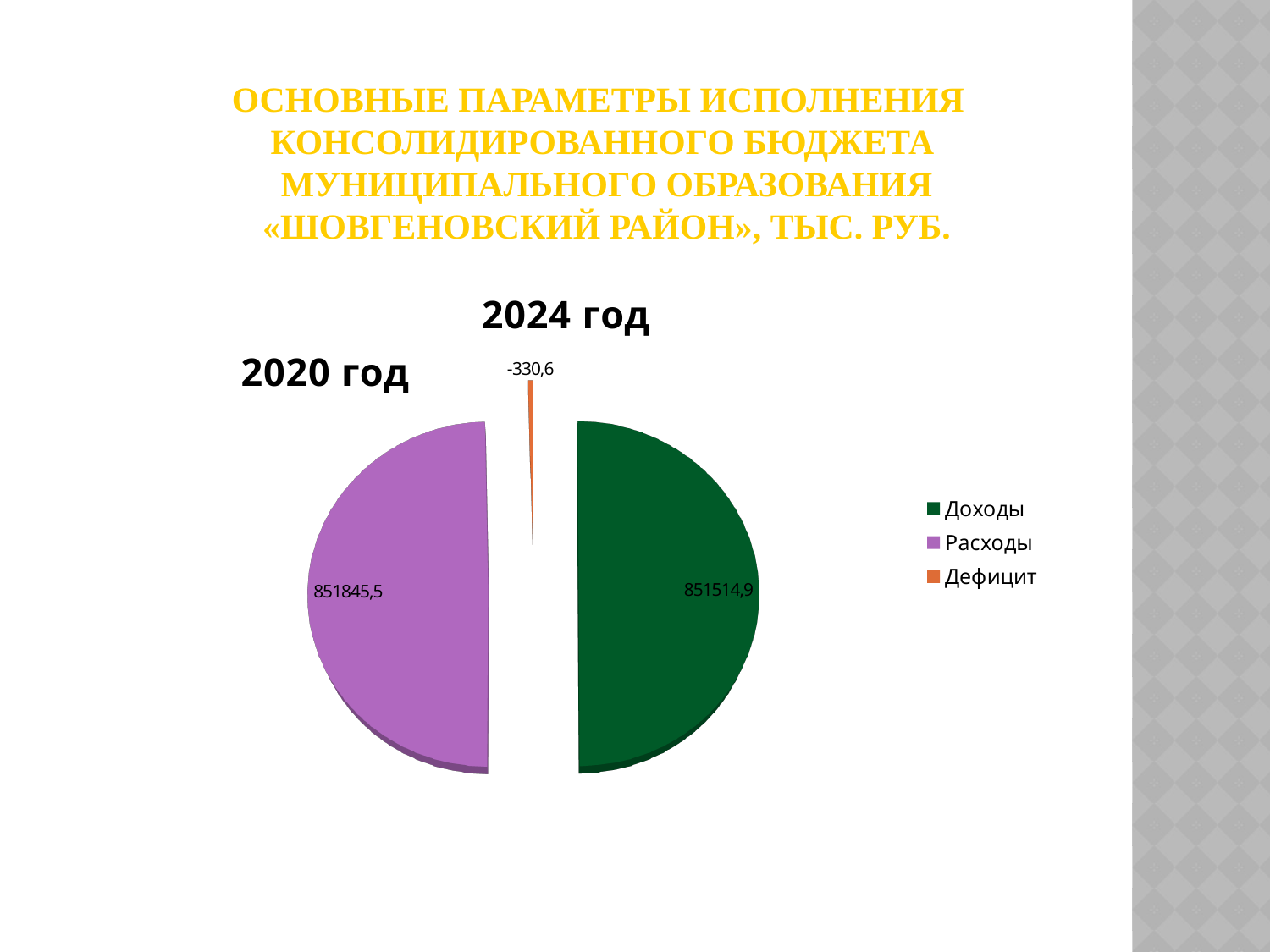
What is the title of the chart? 2024 год What is the difference between the Расходы value and the Доходы value? 330,6 Which category has the smallest value on the pie chart? Дефицит How many entries does the legend list? 3 What colour represents Доходы in the chart? Green Which is larger according to the data labels, Доходы or Расходы? Расходы What is the value shown for Дефицит on the pie chart? -330,6 What is the value shown for Доходы on the pie chart? 851514,9 What is the value shown for Расходы on the pie chart? 851845,5 What kind of chart is shown on the slide? Pie chart How many slices does the pie chart have? 3